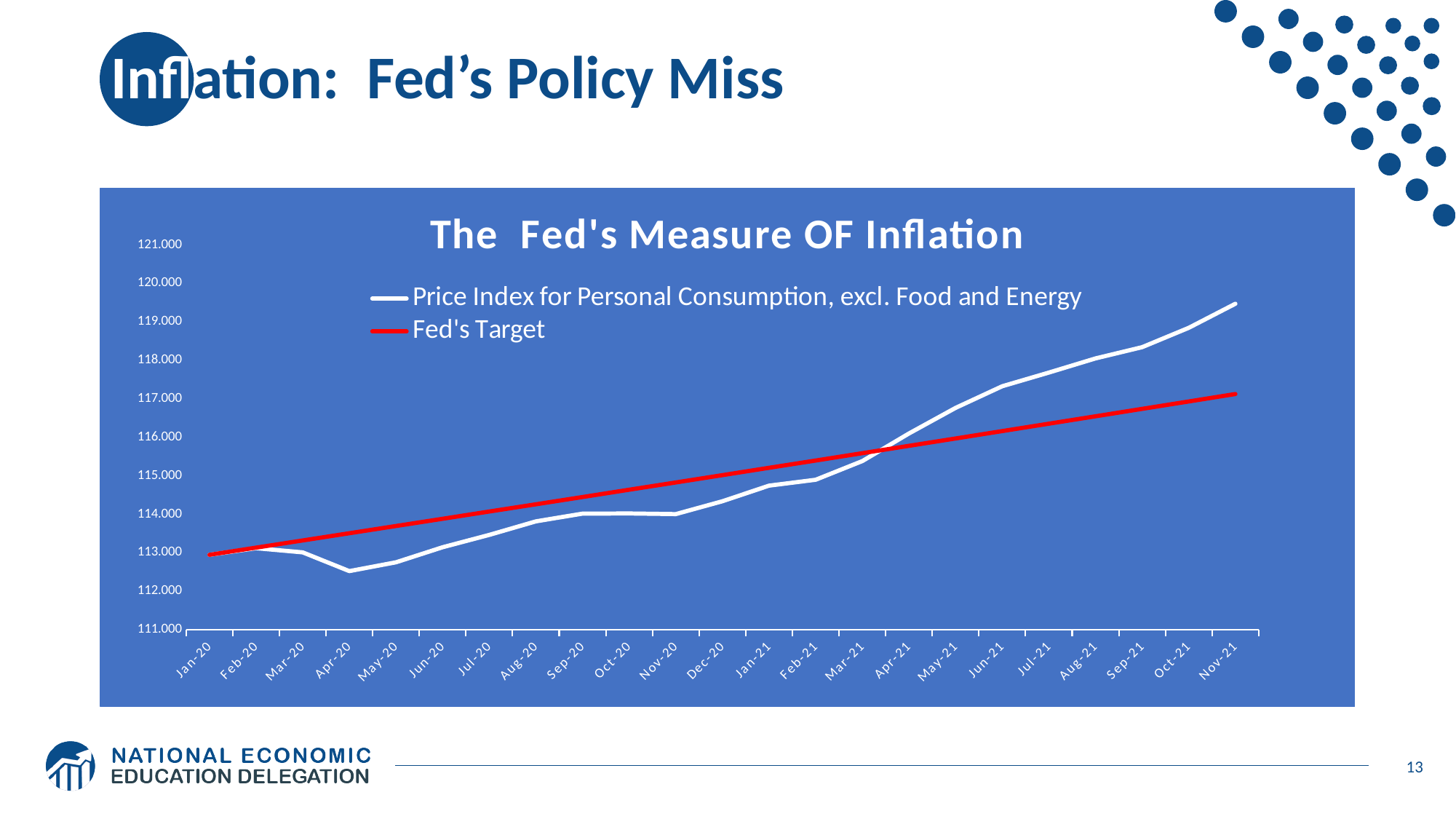
In Nov-21, which series is higher: the Price Index for Personal Consumption, excl. Food and Energy or the Fed's Target? Price Index for Personal Consumption, excl. Food and Energy In Oct-20, which series is higher: the Price Index for Personal Consumption, excl. Food and Energy or the Fed's Target? Fed's Target In which month is the Price Index for Personal Consumption, excl. Food and Energy at its lowest? Apr-20 Is the Price Index for Personal Consumption, excl. Food and Energy in Nov-21 greater or less than 118.000? greater How many series does the legend list? 2 How many months are plotted along the x axis? 23 What is the title of the chart? The Fed's Measure OF Inflation In which month is the Price Index for Personal Consumption, excl. Food and Energy at its highest? Nov-21 Which series is drawn in red? Fed's Target What kind of chart is shown on the slide? line chart Does the Fed's Target line rise or fall from Jan-20 to Nov-21? rise Is the Price Index for Personal Consumption, excl. Food and Energy in Apr-20 greater or less than 113.000? less